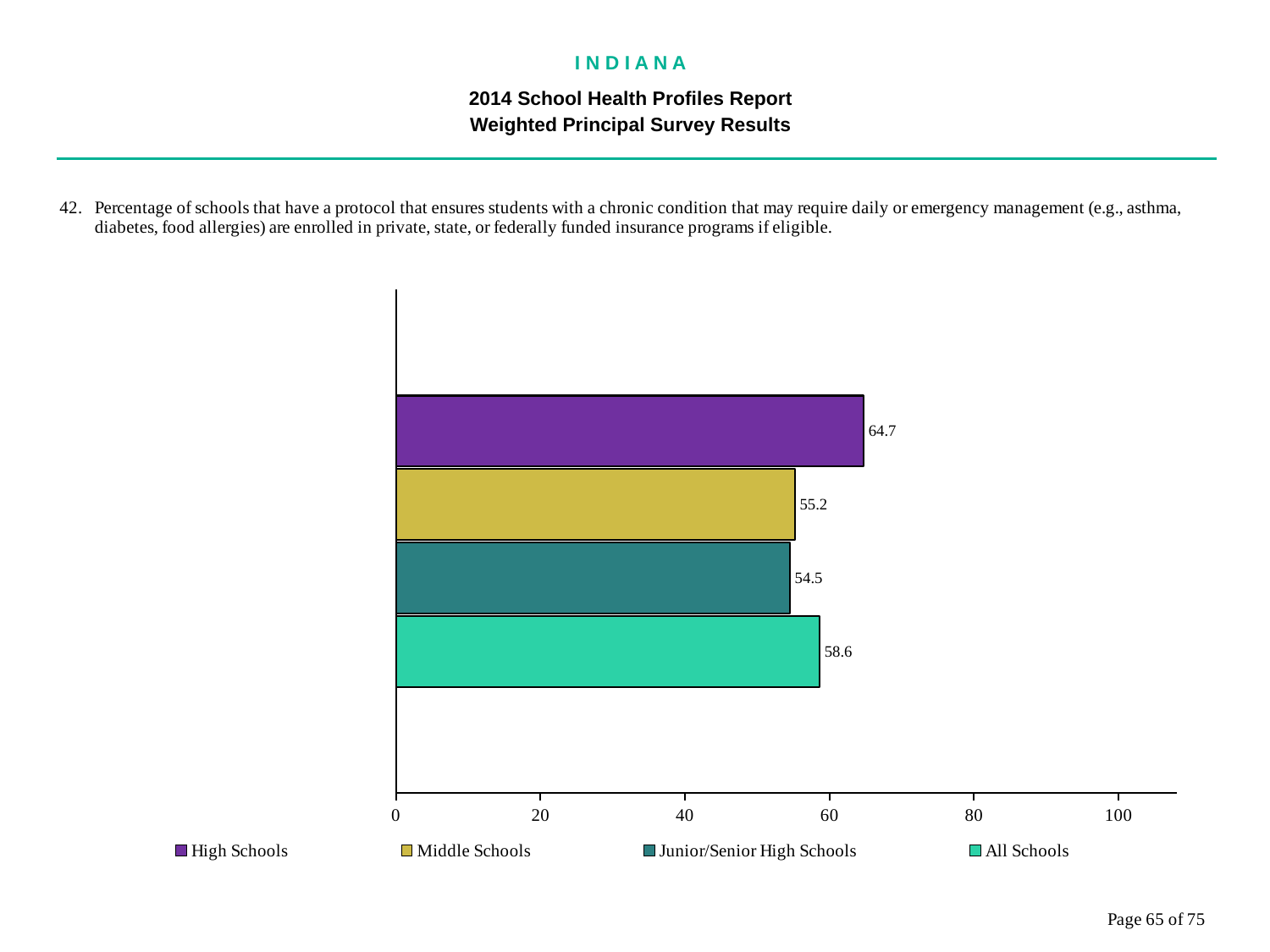
What is the value for All Schools? 58.6 Which school type has the highest value? High Schools What is the value for Middle Schools? 55.2 What kind of chart is shown on the slide? bar chart What is the difference between the High Schools value and the All Schools value? 6.1 What is the value for High Schools? 64.7 Is the value for High Schools greater or less than 60? greater What is the difference between the Middle Schools value and the Junior/Senior High Schools value? 0.7 How many series does the legend list? 4 Which school type has the lowest value? Junior/Senior High Schools What is the value for Junior/Senior High Schools? 54.5 Which is larger, the value for High Schools or the value for All Schools? High Schools